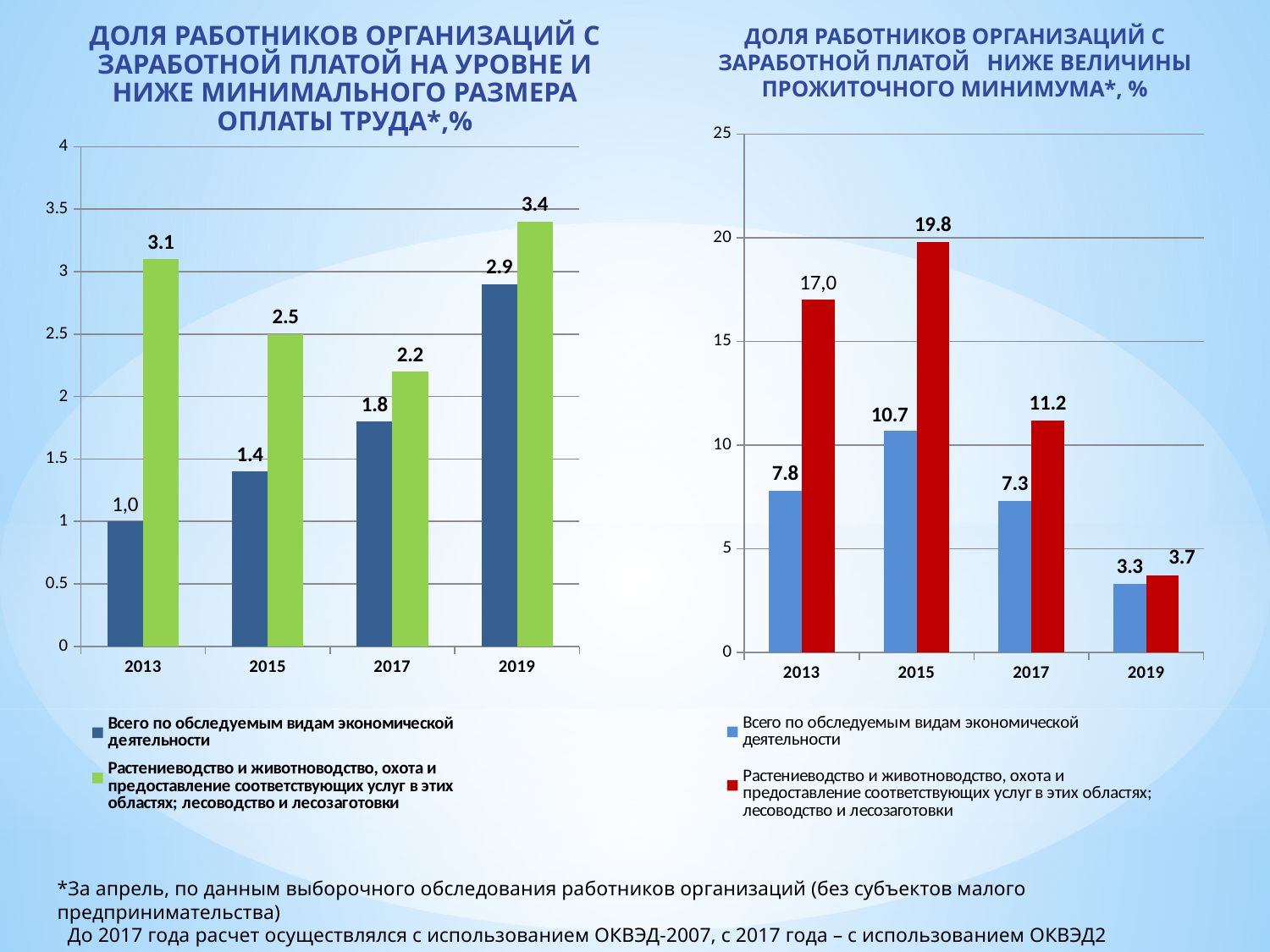
In the left chart, does the value for the series 'Всего по обследуемым видам экономической деятельности' rise or fall from 2013 to 2019? Rise What type of chart is the right chart? Bar chart In the right chart, which year has the highest value for the series 'Всего по обследуемым видам экономической деятельности'? 2015 In the right chart, what is the value for 2013 for the series 'Всего по обследуемым видам экономической деятельности'? 7.8 In the right chart, what is the value for 2015 for the series 'Растениеводство и животноводство, охота и предоставление соответствующих услуг в этих областях; лесоводство и лесозаготовки'? 19.8 How many years are shown on the x axis of the right chart? 4 In the right chart, what is the difference between the two series' values in 2017? 3.9 How many series does the legend of the left chart list? 2 In the left chart, which series has the larger value in 2017? Растениеводство и животноводство, охота и предоставление соответствующих услуг в этих областях; лесоводство и лесозаготовки In the left chart, which year has the lowest value for the series 'Всего по обследуемым видам экономической деятельности'? 2013 In the left chart, what is the value for 2015 for the series 'Растениеводство и животноводство, охота и предоставление соответствующих услуг в этих областях; лесоводство и лесозаготовки'? 2.5 In the left chart, what is the value for 2019 for the series 'Всего по обследуемым видам экономической деятельности'? 2.9